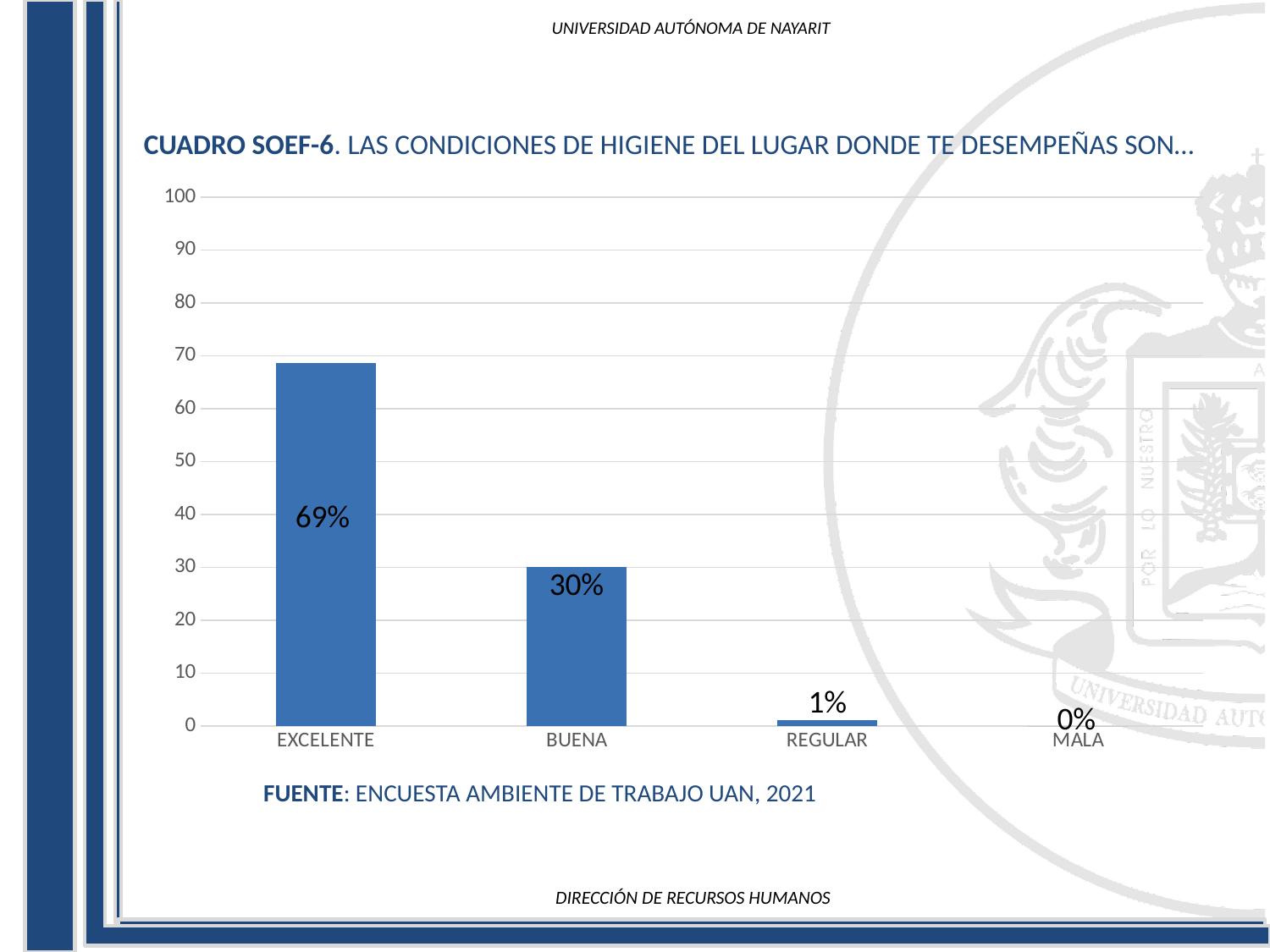
What is the difference between the values for EXCELENTE and BUENA? 39% What is the value for MALA? 0% What kind of chart is shown on the slide? bar chart What source is cited below the chart? ENCUESTA AMBIENTE DE TRABAJO UAN, 2021 Which is larger, the value for BUENA or the value for REGULAR? BUENA What is the value for BUENA? 30% Which category has the highest value? EXCELENTE What is the value for REGULAR? 1% Is the value for EXCELENTE greater or less than 60? greater What is the value for EXCELENTE? 69% Which category has the lowest value? MALA How many categories are shown on the x axis? 4